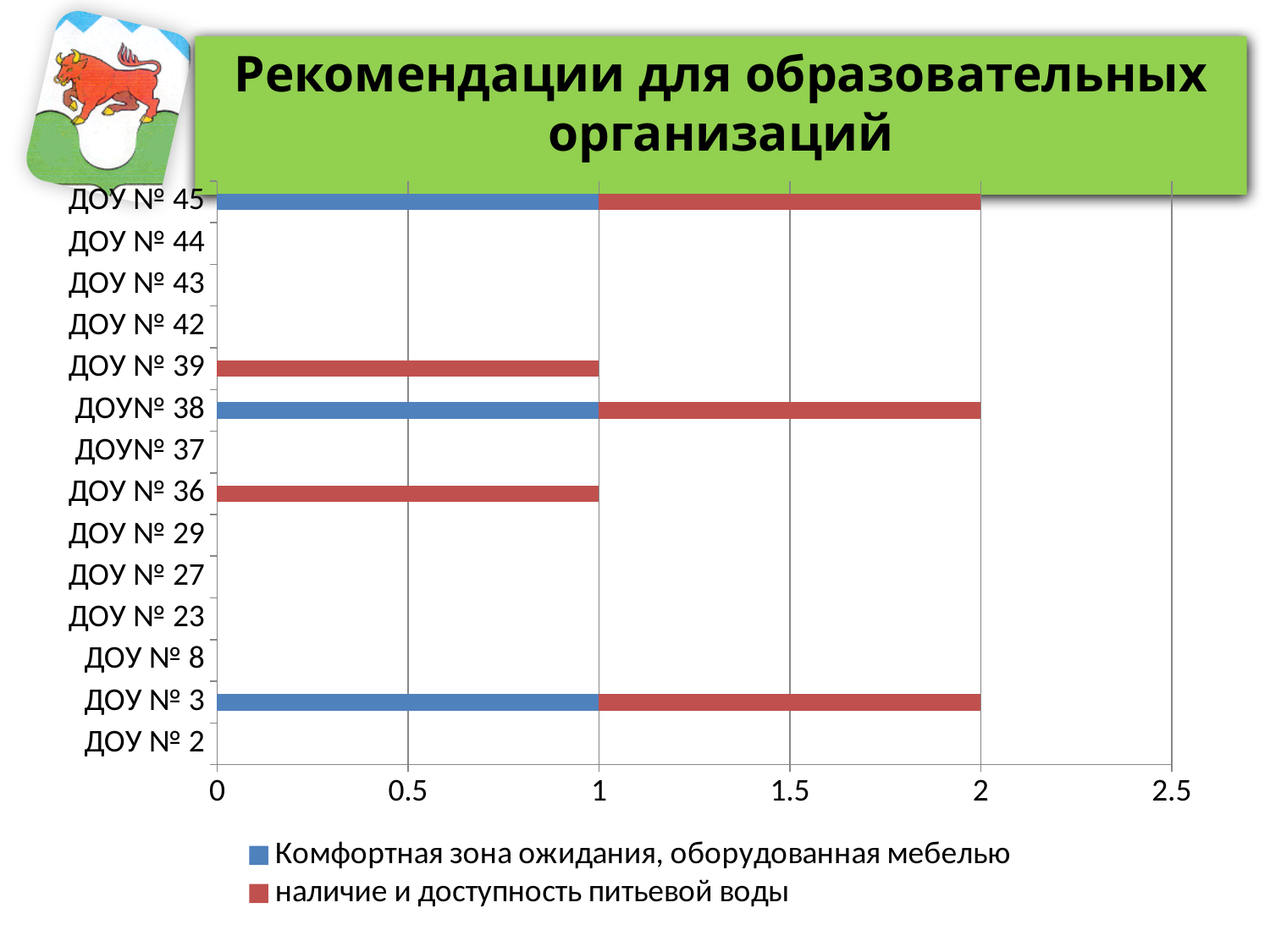
What is the total of the stacked bar for ДОУ № 3? 2 How many categories (ДОУ) are listed on the vertical axis? 14 How many series does the legend list? 2 What kind of chart is shown on the slide? bar chart What is the difference between the total bar for ДОУ № 3 and the total bar for ДОУ № 36? 1 What is the value of "Комфортная зона ожидания, оборудованная мебелью" for ДОУ № 45? 1 Which is larger: the total bar for ДОУ № 45 or the total bar for ДОУ № 36? ДОУ № 45 What is the title of the slide containing the chart? Рекомендации для образовательных организаций Is the total bar for ДОУ № 38 greater or less than 1.5? greater Which colour represents "наличие и доступность питьевой воды" in the legend? red What is the total of the stacked bar for ДОУ № 38? 2 What is the value of "наличие и доступность питьевой воды" for ДОУ № 39? 1